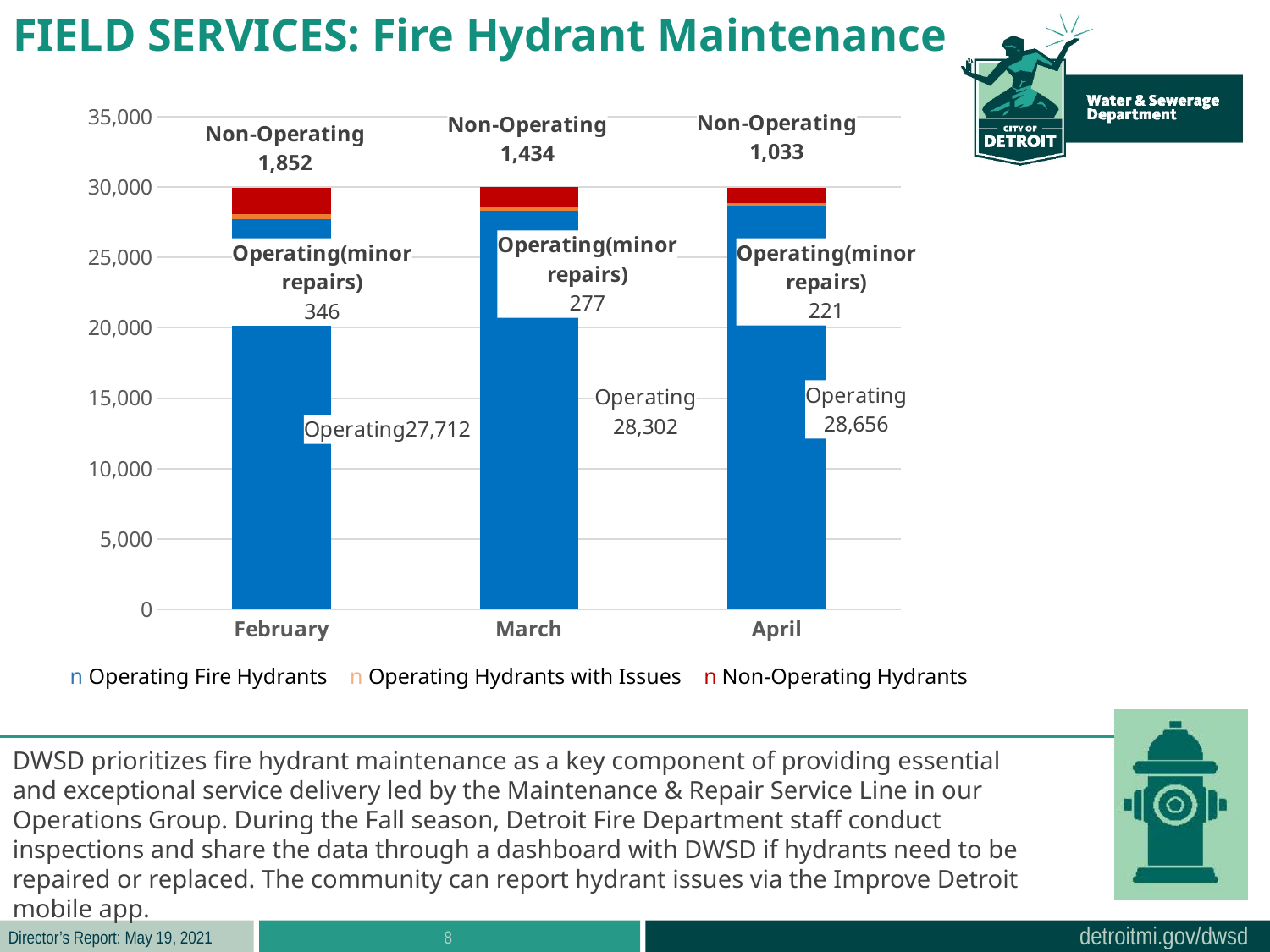
How many months are shown on the x axis of the chart? 3 How many series does the chart legend list? 3 What is the number of Non-Operating Hydrants in March? 1,434 Do the Non-Operating Hydrant values rise or fall from February to April? Fall Which month has the highest number of Non-Operating Hydrants? February What is the difference between the Non-Operating Hydrants in February and in April? 819 Which month has the lowest number of Operating Fire Hydrants? February What kind of chart is shown on the slide? Stacked bar chart Is the number of Operating Fire Hydrants in March larger or smaller than in April? Smaller What is the number of Operating Fire Hydrants in February? 27,712 What is the number of Operating Hydrants with Issues (minor repairs) in April? 221 What is the total number of hydrants in the March stacked bar? 30,013